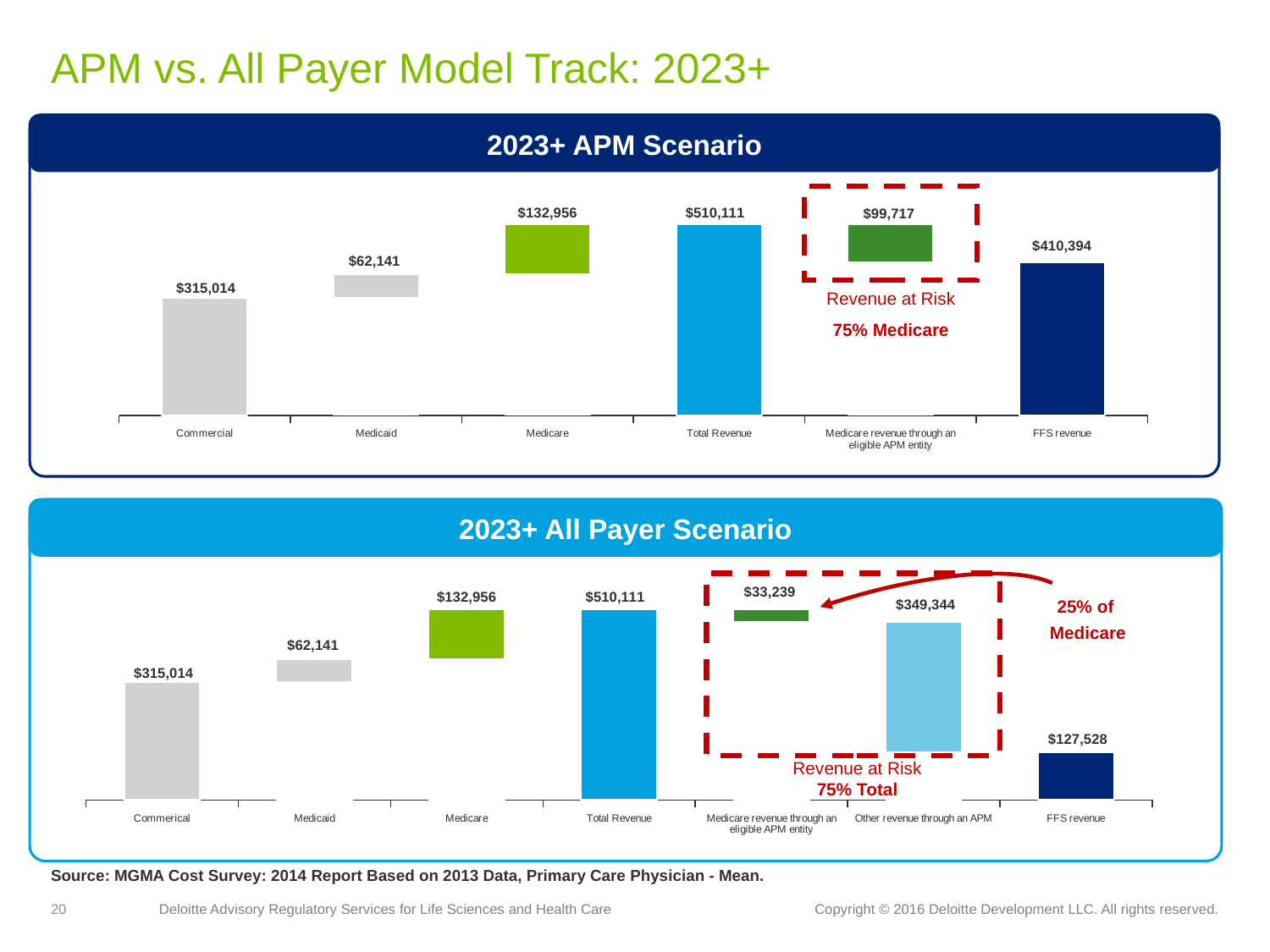
In the 2023+ All Payer Scenario chart, what is the value for Other revenue through an APM? $349,344 In the 2023+ APM Scenario chart, what is the value for FFS revenue? $410,394 In the 2023+ APM Scenario chart, which category has the lowest value? Medicaid In the 2023+ All Payer Scenario chart, which category has the highest value? Total Revenue What kind of chart is the 2023+ All Payer Scenario chart? Bar chart In the 2023+ APM Scenario chart, what is the value for Commercial? $315,014 In the 2023+ APM Scenario chart, how many categories are shown on the x axis? 6 In the 2023+ All Payer Scenario chart, which is larger: Medicare revenue through an eligible APM entity or FFS revenue? FFS revenue In the 2023+ APM Scenario chart, what is the difference between Total Revenue and FFS revenue? $99,717 In the 2023+ All Payer Scenario chart, what is the value for FFS revenue? $127,528 In the 2023+ All Payer Scenario chart, what is the difference between Other revenue through an APM and FFS revenue? $221,816 In the 2023+ APM Scenario chart, what is the value for Medicare revenue through an eligible APM entity? $99,717